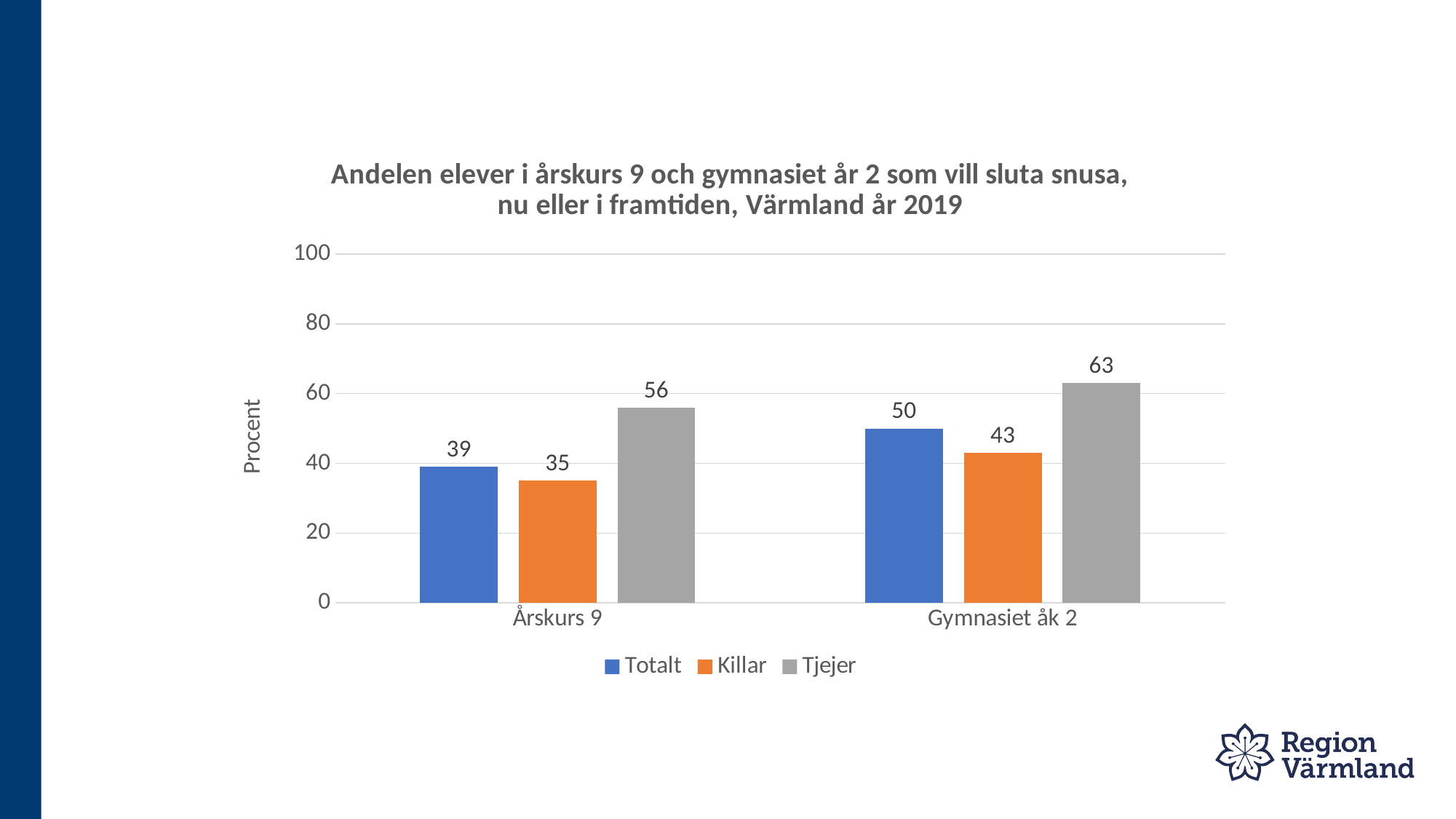
Which series has the highest value in Gymnasiet åk 2? Tjejer Which series has the lowest value in Årskurs 9? Killar What is the difference between Tjejer and Killar in Gymnasiet åk 2? 20 What is the label of the y axis? Procent How many series does the legend list? 3 What is the value for Killar in Gymnasiet åk 2? 43 How many categories are shown on the x axis? 2 Which is larger: Killar in Gymnasiet åk 2 or Totalt in Årskurs 9? Killar in Gymnasiet åk 2 What is the value for Tjejer in Årskurs 9? 56 What is the value for Totalt in Årskurs 9? 39 What is the difference between the Totalt values for Gymnasiet åk 2 and Årskurs 9? 11 What kind of chart is shown on the slide? Bar chart